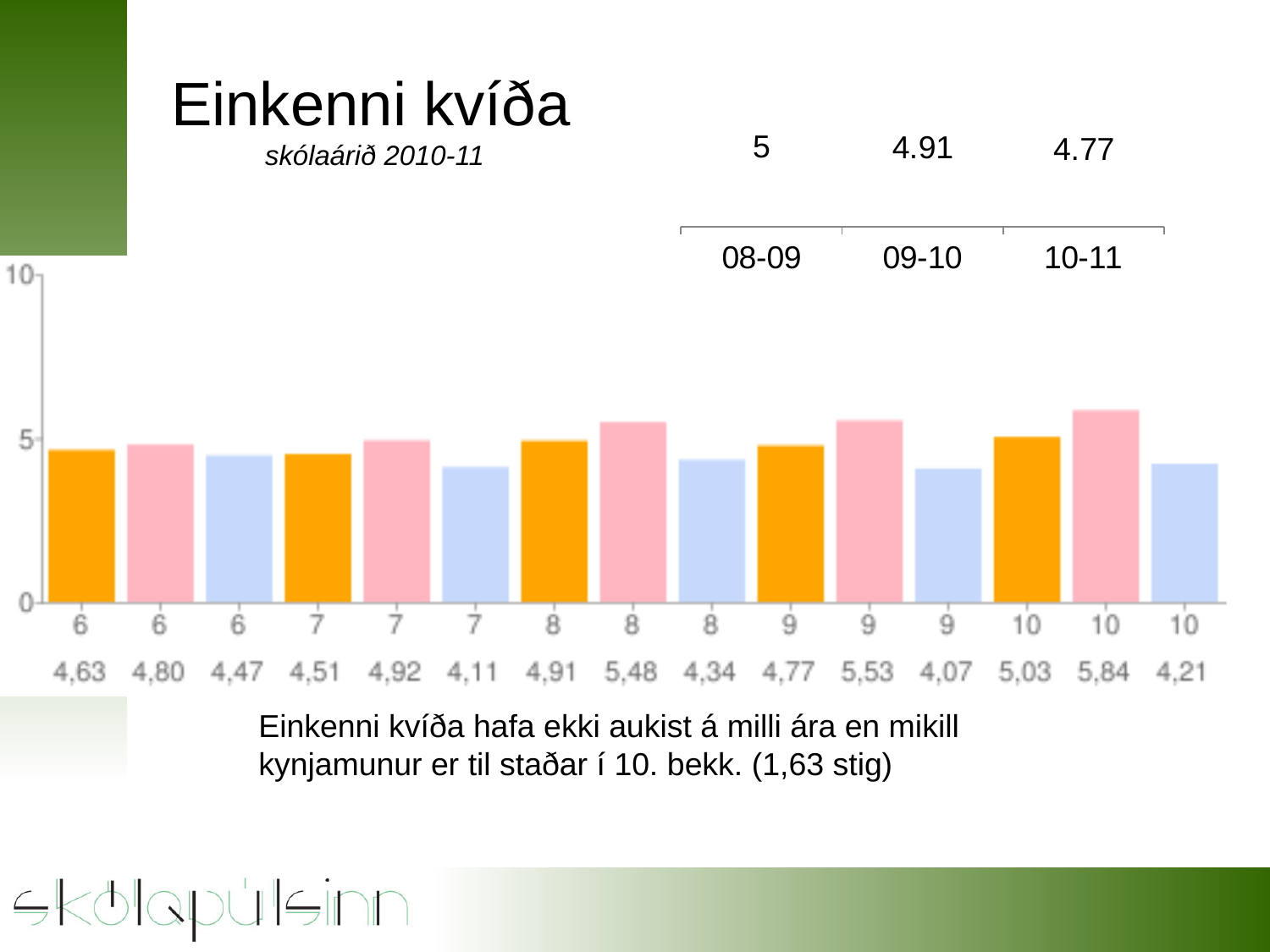
What kind of chart is shown on the slide? bar chart Is the value of the pink bar for grade 8 greater or less than 5? greater What is the value of the pink bar for grade 7? 4,92 What is the value of the orange bar for grade 8? 4,91 What is the value of the blue bar for grade 7? 4,11 What is the difference between the pink bar and the orange bar for grade 9? 0,76 Which bar has the lowest value in the chart? the blue bar for grade 9 (4,07) Which bar has the highest value in the chart? the pink bar for grade 10 (5,84) Which is larger, the orange bar for grade 6 or the orange bar for grade 10? the orange bar for grade 10 In the small table at the top right of the slide, what value is shown for 09-10? 4.91 How many bars are plotted in the chart? 15 What is the difference between the pink bar and the blue bar for grade 10? 1,63